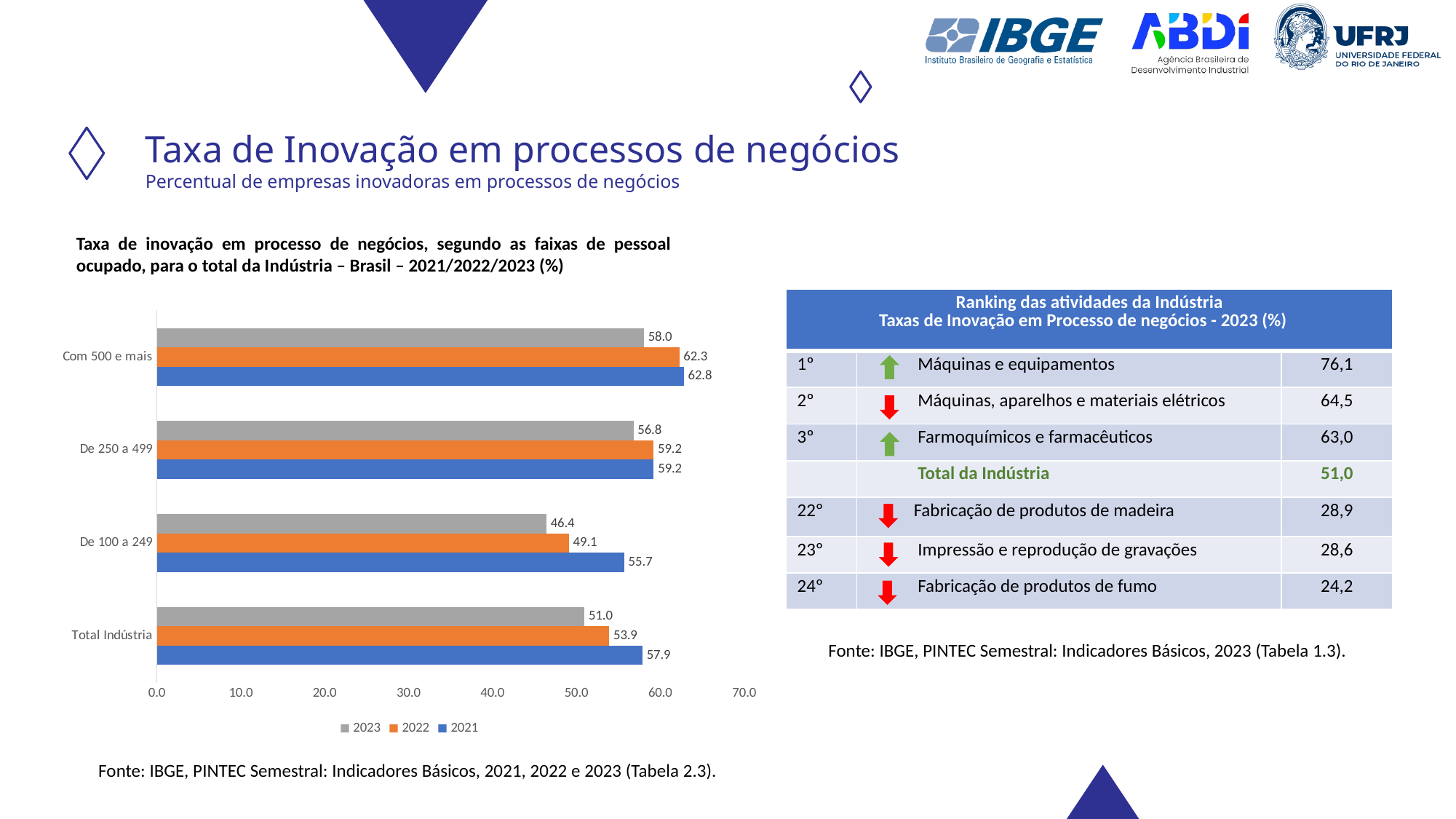
How many categories (faixas de pessoal ocupado) are shown on the chart? 4 Which colour represents the 2022 series in the chart? Orange Is the 2022 value for "De 250 a 499" greater or less than 50.0? greater How many series does the chart legend list? 3 What is the 2021 value for "De 100 a 249"? 55.7 Which category has the highest 2021 value? Com 500 e mais What is the 2023 value for "Com 500 e mais"? 58.0 What kind of chart is shown on the slide? Bar chart What is the difference between the 2021 and 2023 values for "De 100 a 249"? 9.3 Which is larger for "Total Indústria": the 2021 value or the 2023 value? 2021 Which category has the lowest 2023 value? De 100 a 249 What is the 2022 value for "Total Indústria"? 53.9